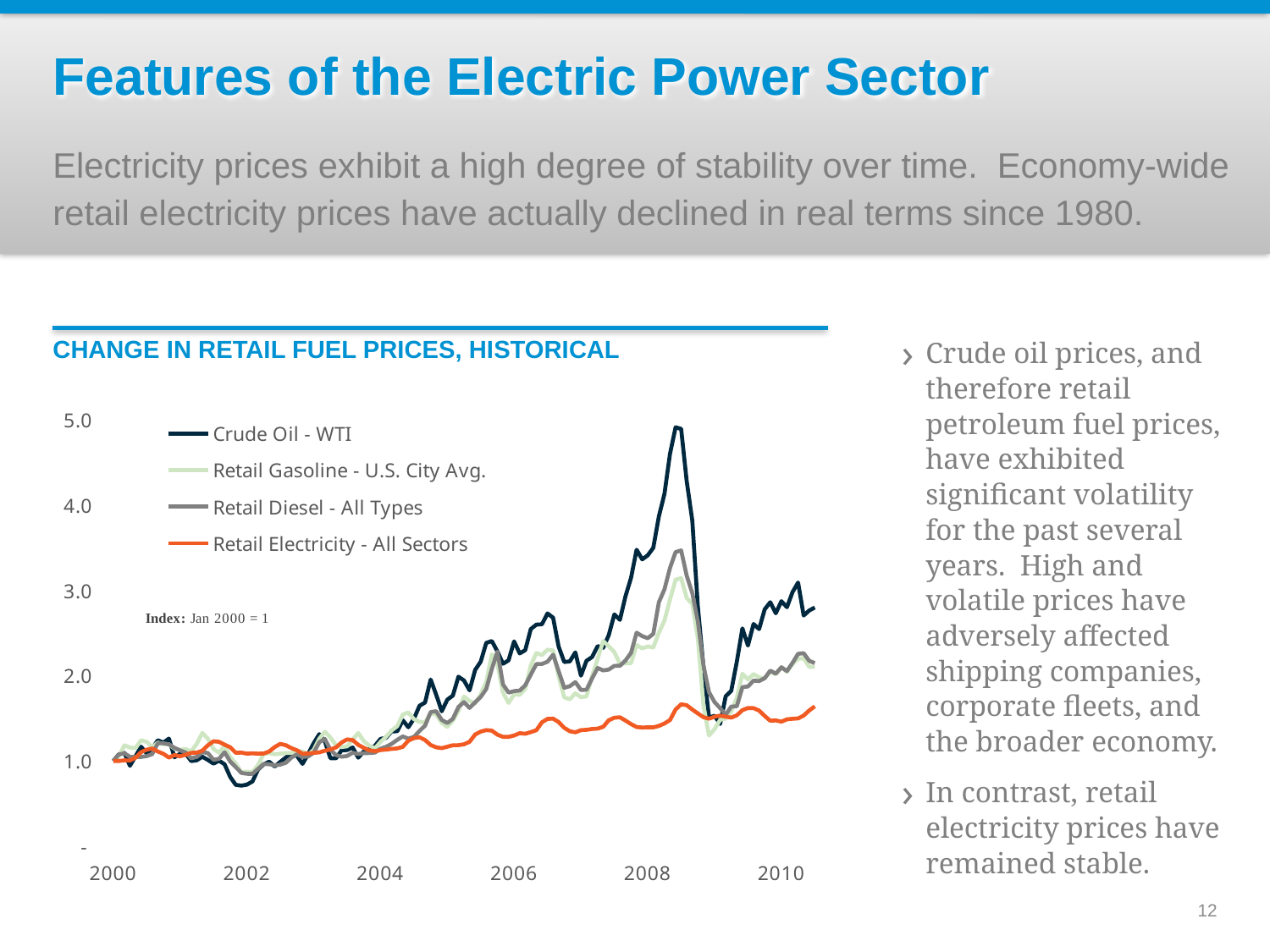
Is the peak value for Crude Oil - WTI in 2008 greater or less than 4.0? greater What kind of chart is shown under the heading "CHANGE IN RETAIL FUEL PRICES, HISTORICAL"? Line chart What is the title of the chart on the slide? CHANGE IN RETAIL FUEL PRICES, HISTORICAL Is the value for Retail Electricity - All Sectors in 2010 greater or less than 2.0? less According to the note on the chart, what is the index base period? Jan 2000 = 1 At the 2008 peak, which is larger: Crude Oil - WTI or Retail Electricity - All Sectors? Crude Oil - WTI How many series does the legend of the chart list? 4 Which series reaches the highest value on the chart? Crude Oil - WTI What is the first year labelled on the x axis of the chart? 2000 Does the Retail Electricity - All Sectors line generally rise or fall from 2000 to 2010? Rise Is the peak value for Retail Diesel - All Types in 2008 greater or less than 3.0? greater Which series stays the lowest during the 2008 price spike? Retail Electricity - All Sectors